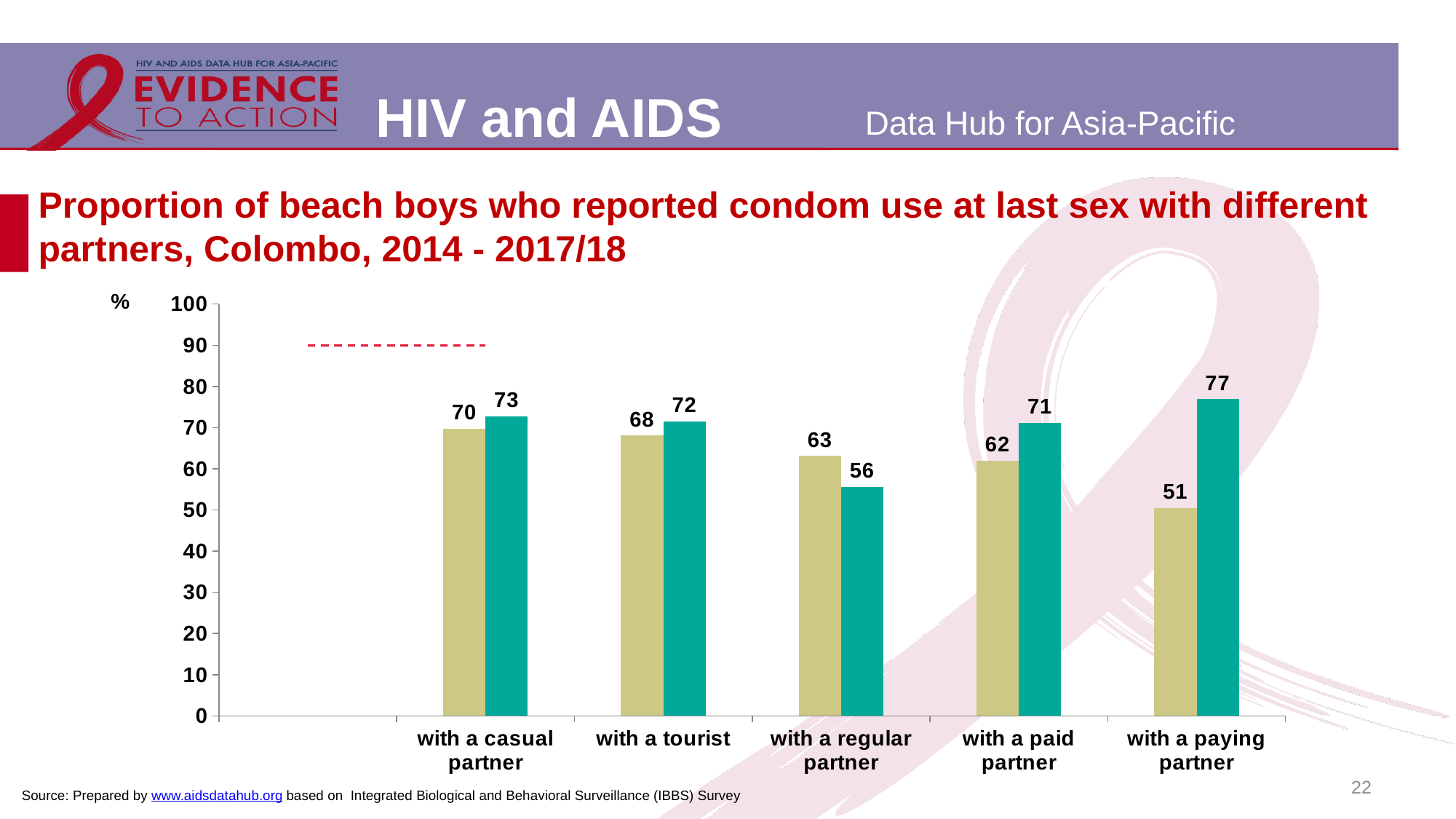
Which partner category has the highest teal bar? with a paying partner What is the difference between the teal and tan bars for "with a paying partner"? 26 What is the value of the tan bar for "with a regular partner"? 63 What unit is shown on the y axis of the chart? % For "with a paid partner", which bar is larger, the tan bar or the teal bar? the teal bar What kind of chart is shown on the slide? bar chart What is the value of the teal bar for "with a tourist"? 72 What is the value of the teal bar for "with a paying partner"? 77 What is the difference between the tan and teal bars for "with a regular partner"? 7 Which partner category has the lowest tan bar? with a paying partner How many partner categories are shown on the x axis? 5 Is the tan bar for "with a casual partner" greater or less than 60? greater